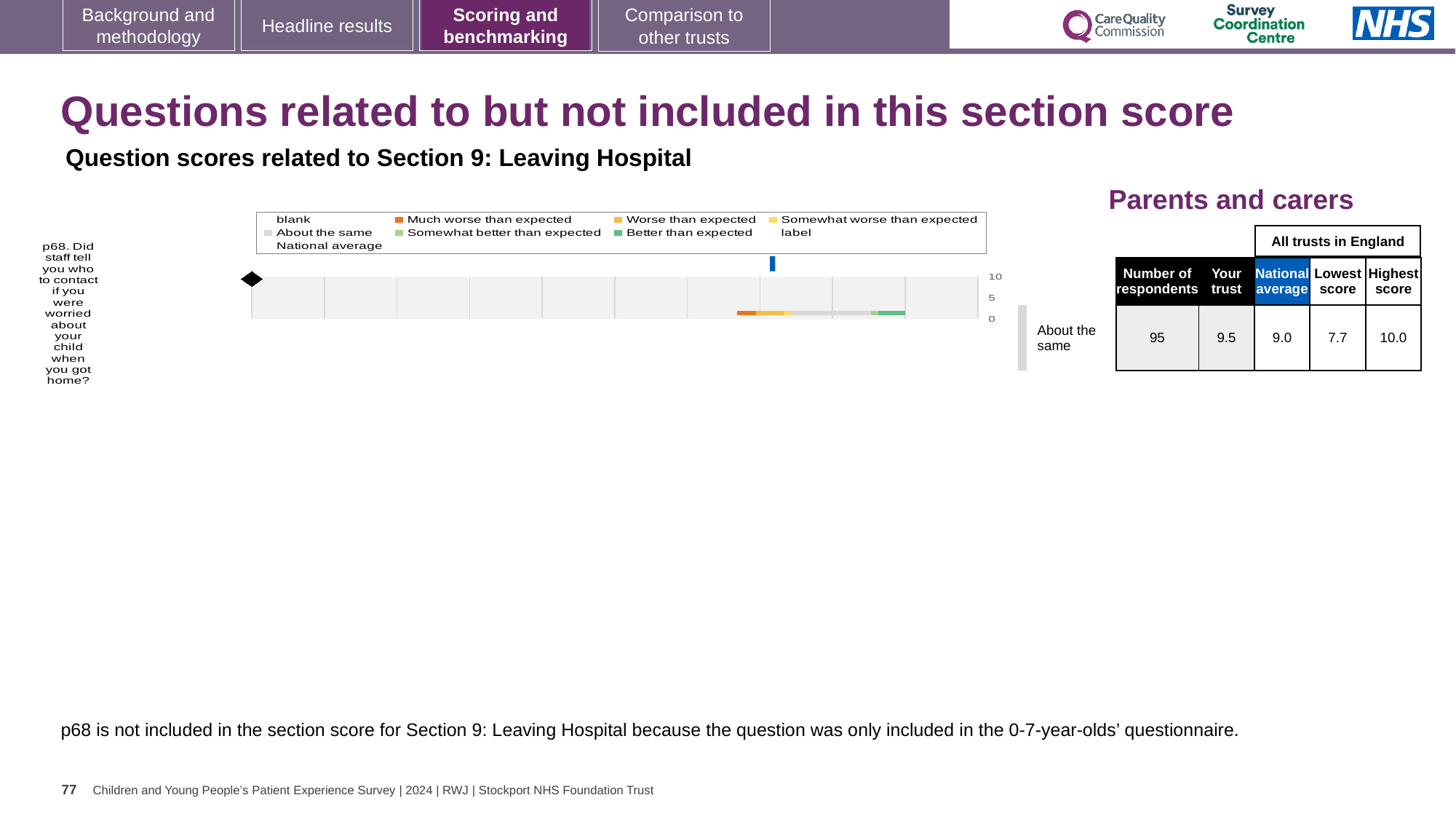
In the table beside the chart, which is larger for p68: the 'Your trust' score or the national average? Your trust How many questions (categories) are plotted in the chart? 1 What benchmark category is shown next to the chart for p68? About the same What colour does the legend use for 'Better than expected'? green What colour does the legend use for 'Much worse than expected'? orange What kind of chart is shown on the slide? bar chart Which question is plotted in the chart? p68. Did staff tell you who to contact if you were worried about your child when you got home? In the table beside the chart, what is the national average for p68? 9.0 In the table beside the chart, what is the 'Your trust' score for p68? 9.5 In the table beside the chart, what is the lowest score across all trusts in England for p68? 7.7 In the table beside the chart, what is the highest score across all trusts in England for p68? 10.0 In the table beside the chart, what is the number of respondents for p68? 95